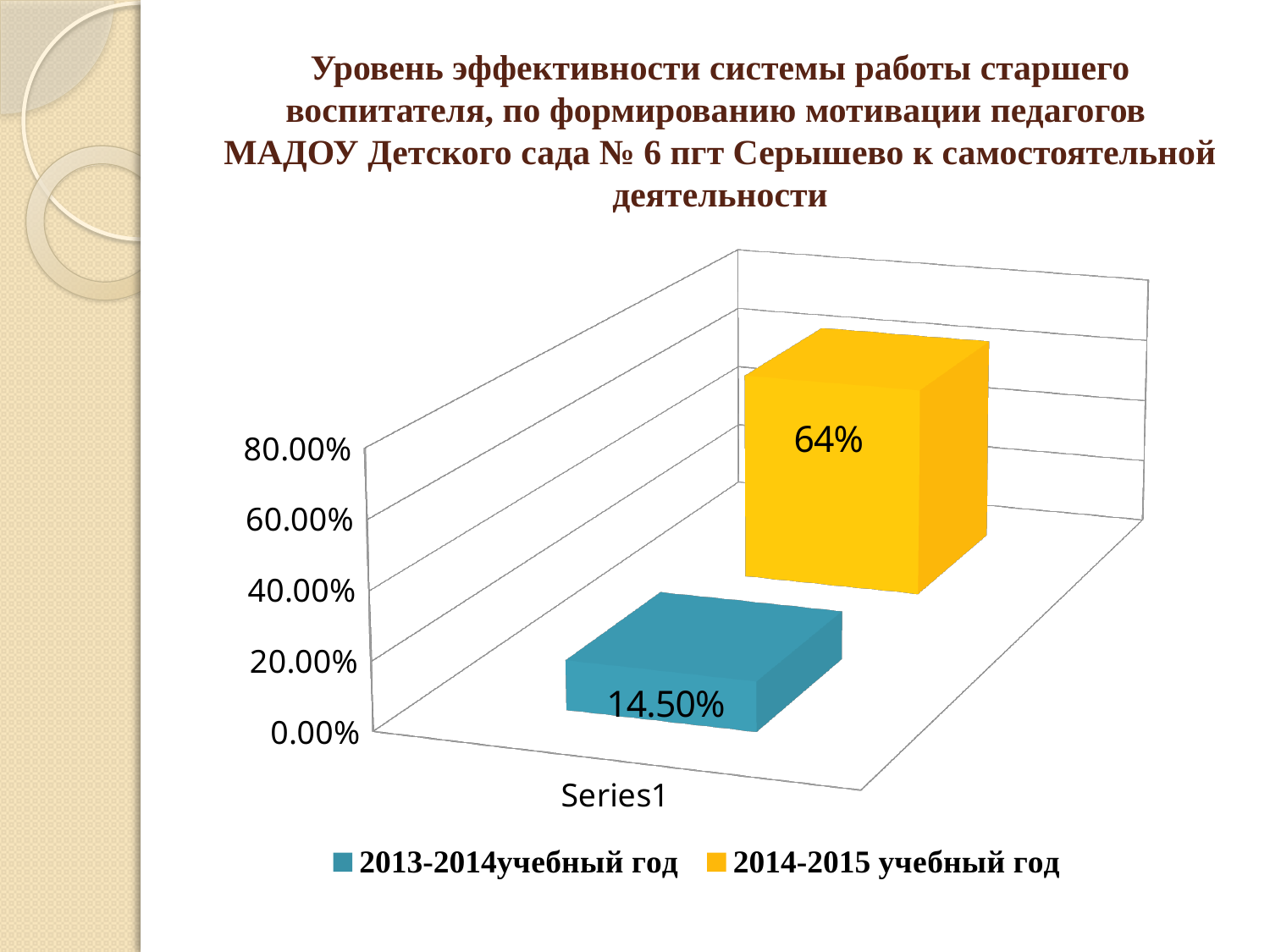
How many series does the legend list? 2 What is the label on the category axis of the chart? Series1 What is the value for 2013-2014 учебный год? 14.50% What is the value for 2014-2015 учебный год? 64% What kind of chart is shown on the slide? bar chart Is the value for 2014-2015 учебный год greater or less than 60.00%? greater Which series has the higher value, 2013-2014 учебный год or 2014-2015 учебный год? 2014-2015 учебный год What colour is the bar for 2014-2015 учебный год? yellow What is the difference between the value for 2014-2015 учебный год and the value for 2013-2014 учебный год? 49.50% Is the value for 2013-2014 учебный год larger or smaller than the value for 2014-2015 учебный год? smaller Is the value for 2013-2014 учебный год greater or less than 20.00%? less Which series has the lowest value? 2013-2014 учебный год